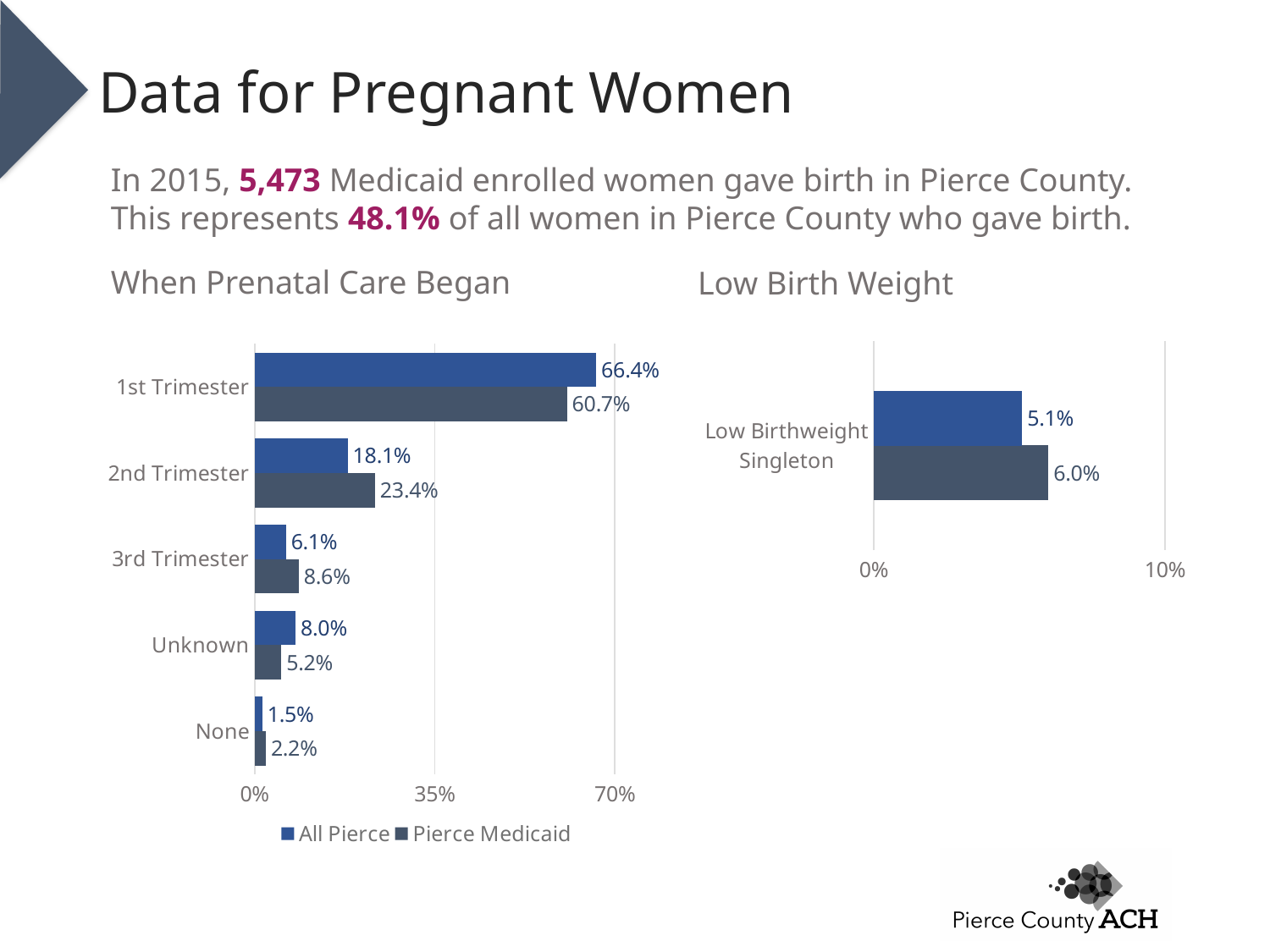
In the 'When Prenatal Care Began' chart, what is the Pierce Medicaid value for 2nd Trimester? 23.4% In the 'When Prenatal Care Began' chart, what is the Pierce Medicaid value for Unknown? 5.2% In the 'When Prenatal Care Began' chart, which category has the lowest Pierce Medicaid value? None In the 'When Prenatal Care Began' chart, what is the difference between the All Pierce and Pierce Medicaid values for 1st Trimester? 5.7% How many categories are shown in the 'When Prenatal Care Began' chart? 5 In the 'When Prenatal Care Began' chart, what is the All Pierce value for 1st Trimester? 66.4% What kind of chart is the 'Low Birth Weight' chart? Bar chart In the 'Low Birth Weight' chart, what is the difference between the two bars for Low Birthweight Singleton? 0.9% How many series does the legend of the 'When Prenatal Care Began' chart list? 2 In the 'When Prenatal Care Began' chart, which category has the highest All Pierce value? 1st Trimester In the 'When Prenatal Care Began' chart, which is larger for 3rd Trimester: All Pierce or Pierce Medicaid? Pierce Medicaid In the 'Low Birth Weight' chart, what is the value of the darker (lower) bar for Low Birthweight Singleton? 6.0%